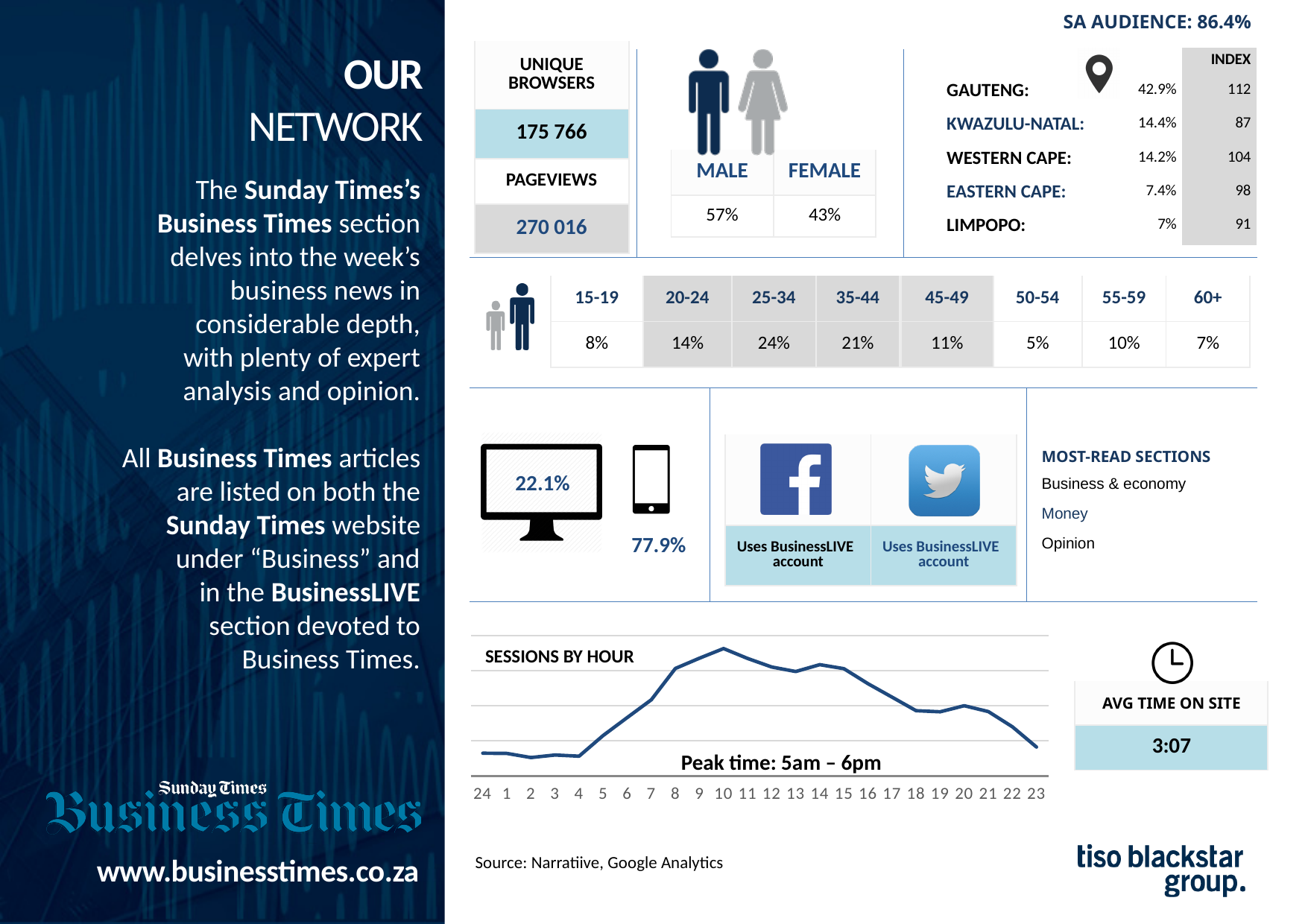
In the "Sessions by Hour" chart, is the value at hour 10 higher or lower than the value at hour 23? higher Do the values in the "Sessions by Hour" chart rise or fall between hour 4 and hour 10? rise What is the first hour label on the x axis of the "Sessions by Hour" chart? 24 Do the values in the "Sessions by Hour" chart rise or fall between hour 14 and hour 23? fall At which hour does the "Sessions by Hour" line reach its highest point? 10 What is the last hour label on the x axis of the "Sessions by Hour" chart? 23 How many hour points are plotted along the x axis of the "Sessions by Hour" chart? 24 In the "Sessions by Hour" chart, which hour has the higher value, 14 or 19? 14 What is the title of the line chart on the slide? SESSIONS BY HOUR In the "Sessions by Hour" chart, which hour has the higher value, 4 or 8? 8 What peak time is annotated on the "Sessions by Hour" chart? 5am – 6pm What kind of chart is the "Sessions by Hour" chart? line chart